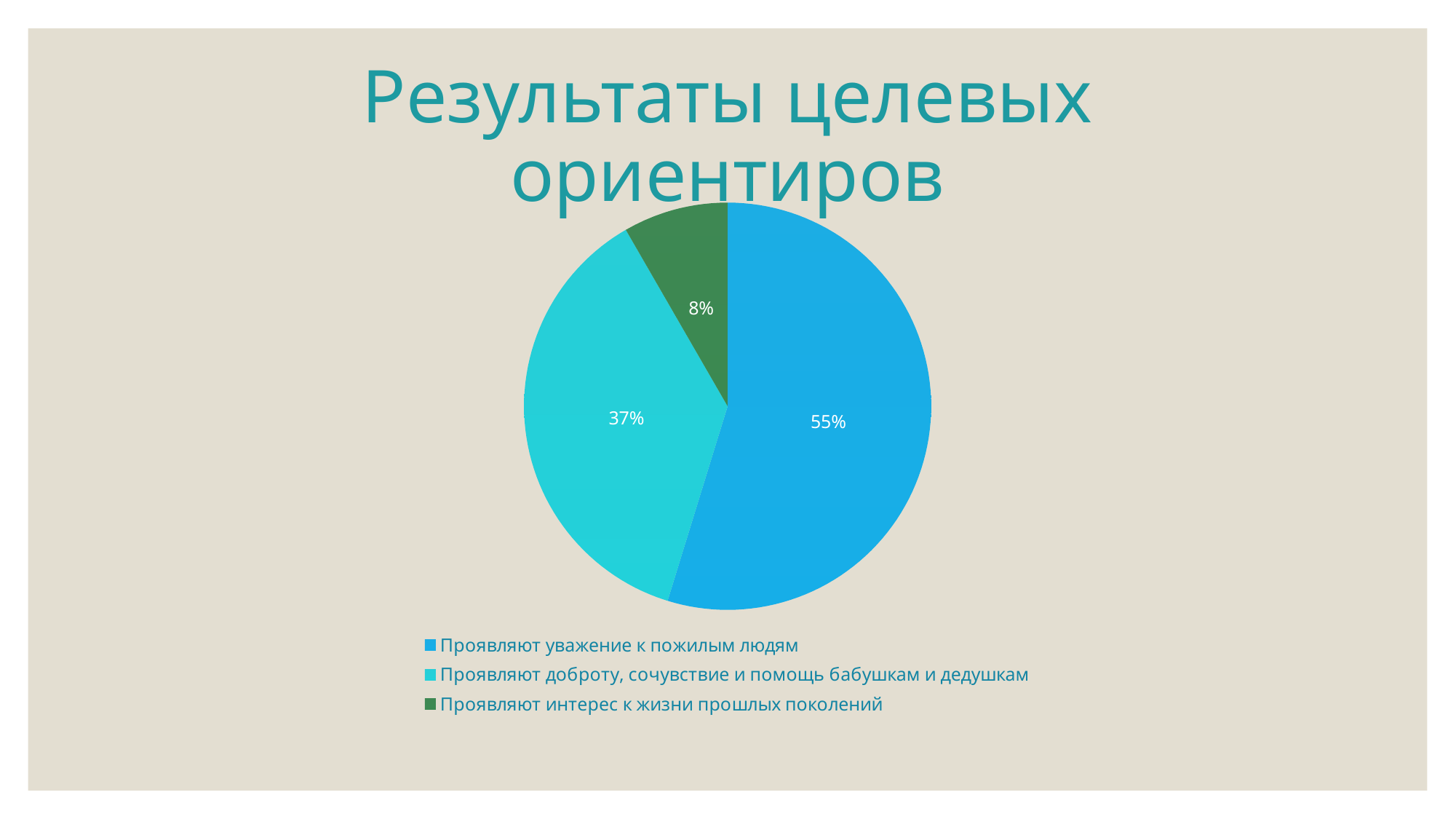
What type of chart is shown on the slide? pie chart What is the difference in percentage points between the 'Проявляют уважение к пожилым людям' slice and the 'Проявляют доброту, сочувствие и помощь бабушкам и дедушкам' slice? 18 How many entries does the legend list? 3 What is the title of the slide containing the chart? Результаты целевых ориентиров What percentage of the pie is labelled for 'Проявляют уважение к пожилым людям'? 55% How many slices does the pie chart have? 3 What colour is the slice for 'Проявляют интерес к жизни прошлых поколений'? green What percentage is shown for 'Проявляют интерес к жизни прошлых поколений'? 8% Which category has the largest slice of the pie? Проявляют уважение к пожилым людям What percentage is shown for 'Проявляют доброту, сочувствие и помощь бабушкам и дедушкам'? 37% Which category has the smallest slice of the pie? Проявляют интерес к жизни прошлых поколений Which is larger: the slice for 'Проявляют доброту, сочувствие и помощь бабушкам и дедушкам' or the slice for 'Проявляют интерес к жизни прошлых поколений'? Проявляют доброту, сочувствие и помощь бабушкам и дедушкам